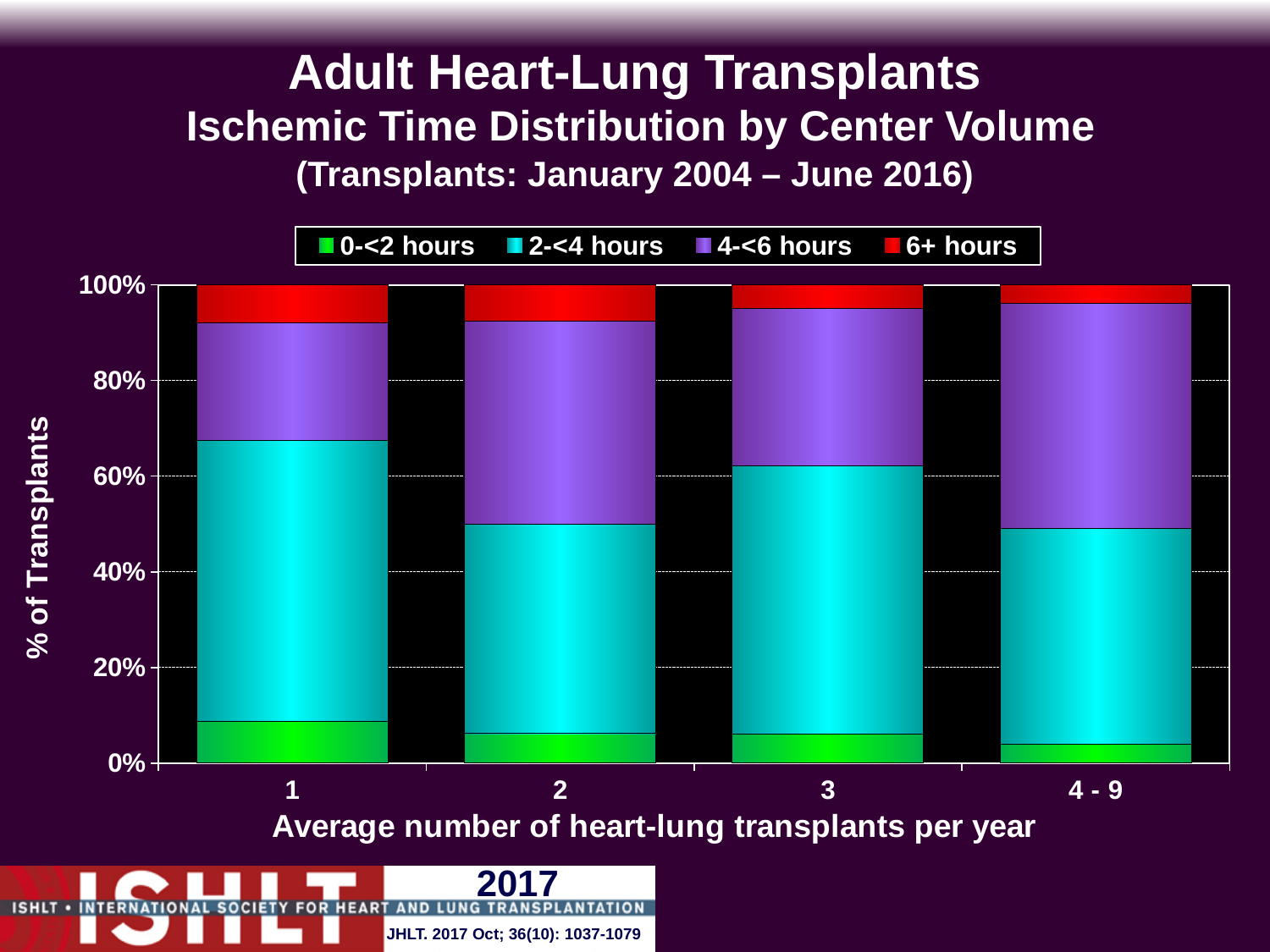
Which is larger: the 2-<4 hours share for the category 1 or for the category 2? 1 Is the 2-<4 hours share for the category 1 greater or less than 40%? greater How many categories are shown on the x axis? 4 Which legend entry is shown in red? 6+ hours What kind of chart is shown on the slide? Stacked bar chart Which category has the smallest 4-<6 hours share? 1 What is the total of the stacked bar for the category 1? 100% How many series does the legend list? 4 Is the 0-<2 hours share for the category 1 greater or less than 20%? less Is the 6+ hours share for the category 3 greater or less than 20%? less Which is larger: the 4-<6 hours share for the category 1 or for the category 2? 2 What is the label of the x axis? Average number of heart-lung transplants per year